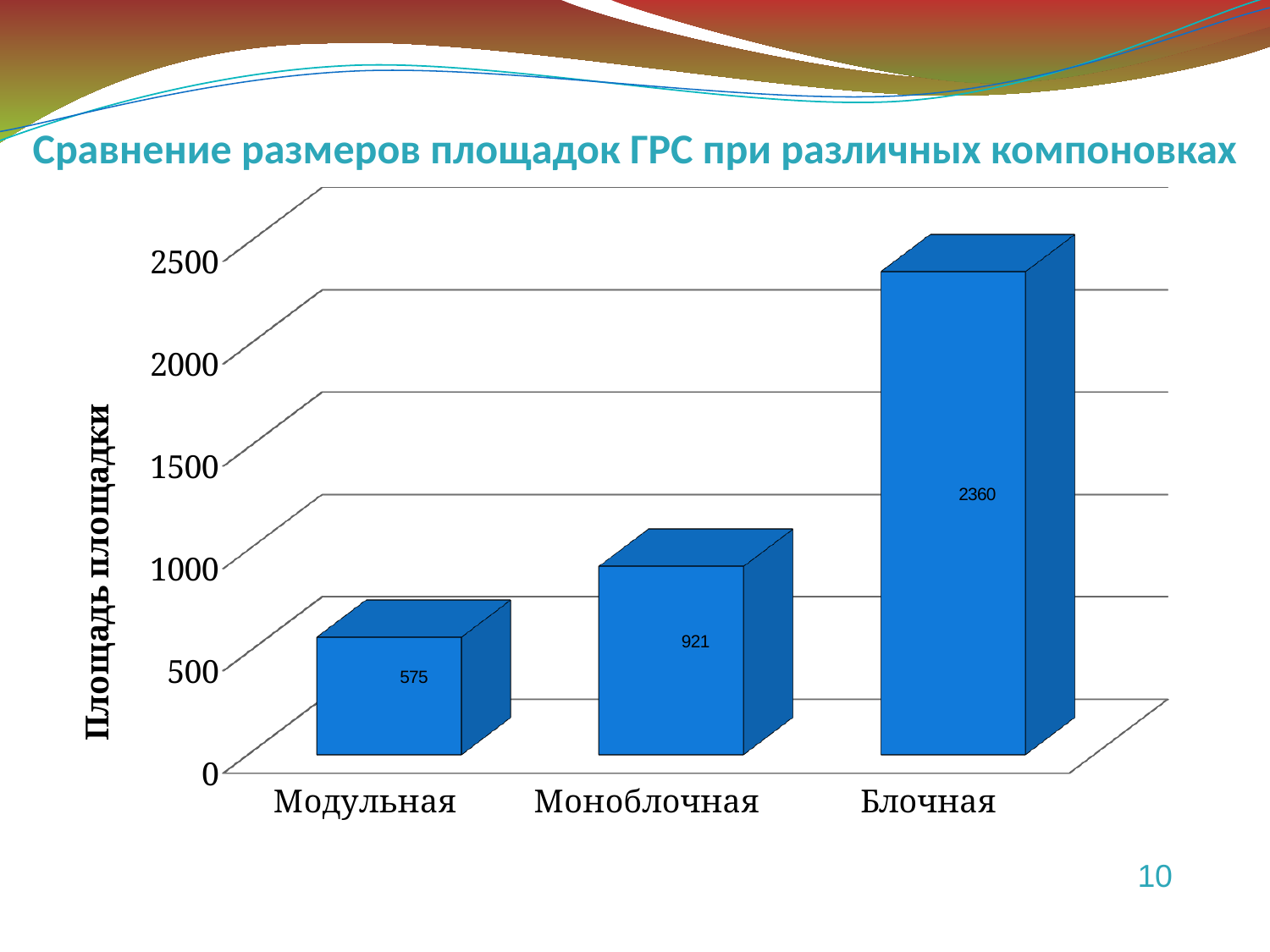
What is the difference between the values for Моноблочная and Модульная? 346 What kind of chart is shown on the slide? bar chart Which category has the highest value? Блочная Which category has the lowest value? Модульная What is the difference between the values for Блочная and Модульная? 1785 Which is larger, the value for Моноблочная or the value for Модульная? Моноблочная What is the label of the vertical axis? Площадь площадки What is the value for Блочная? 2360 What is the value for Моноблочная? 921 Is the value for Блочная greater or less than 2000? greater What is the value for Модульная? 575 How many categories are shown on the x axis? 3